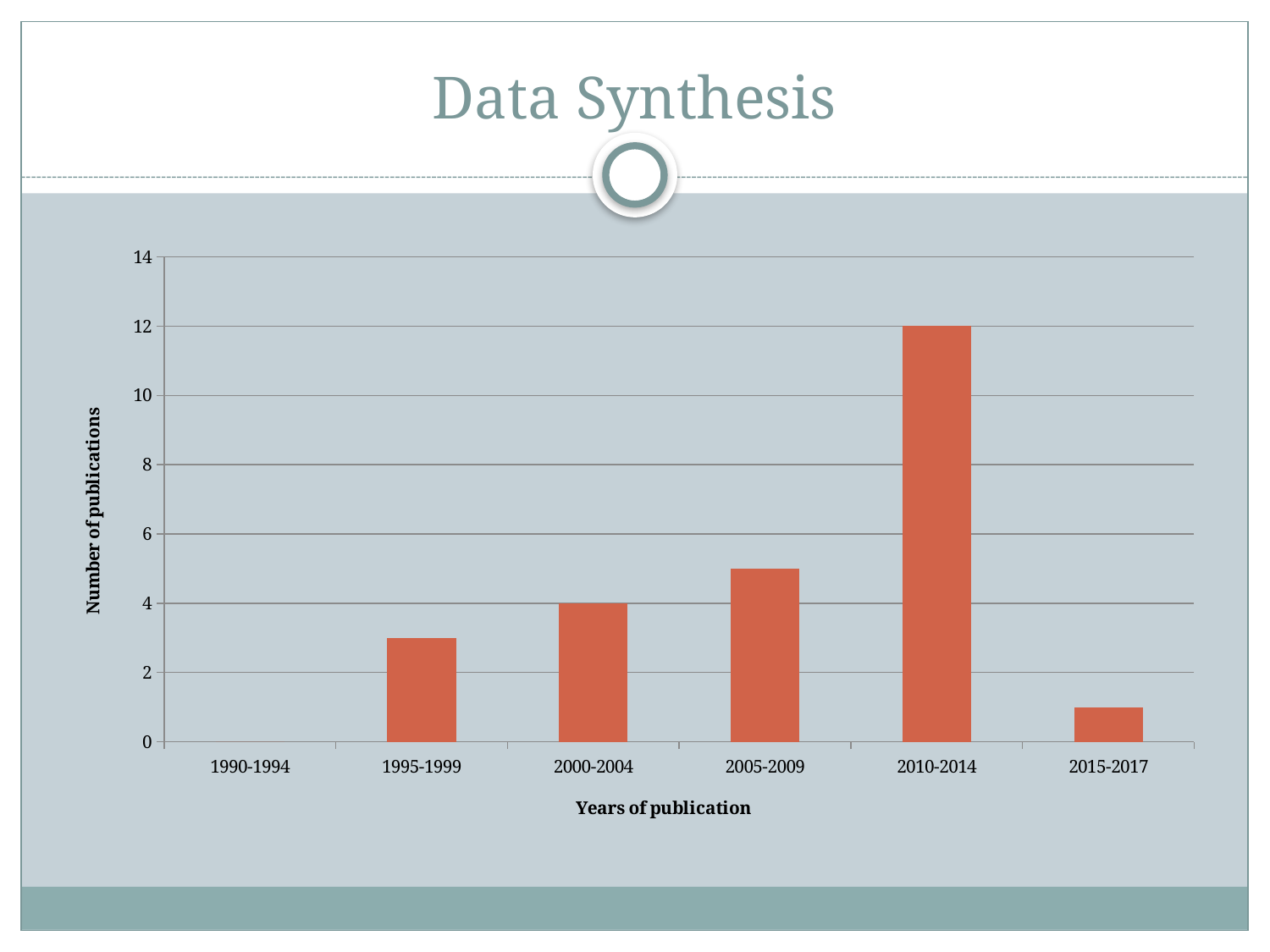
What is the number of publications for 2000-2004? 4 Which has more publications, 2005-2009 or 2000-2004? 2005-2009 What is the label of the y axis? Number of publications Is the number of publications for 2005-2009 greater or less than 4? greater Which year range has the highest number of publications? 2010-2014 Is the number of publications for 2015-2017 greater or less than 2? less What is the number of publications for 2010-2014? 12 How many year-range categories are shown on the x axis? 6 What type of chart is shown on the slide? bar chart What is the number of publications for 1990-1994? 0 What is the difference in number of publications between 2010-2014 and 2000-2004? 8 Which year range has the lowest number of publications? 1990-1994